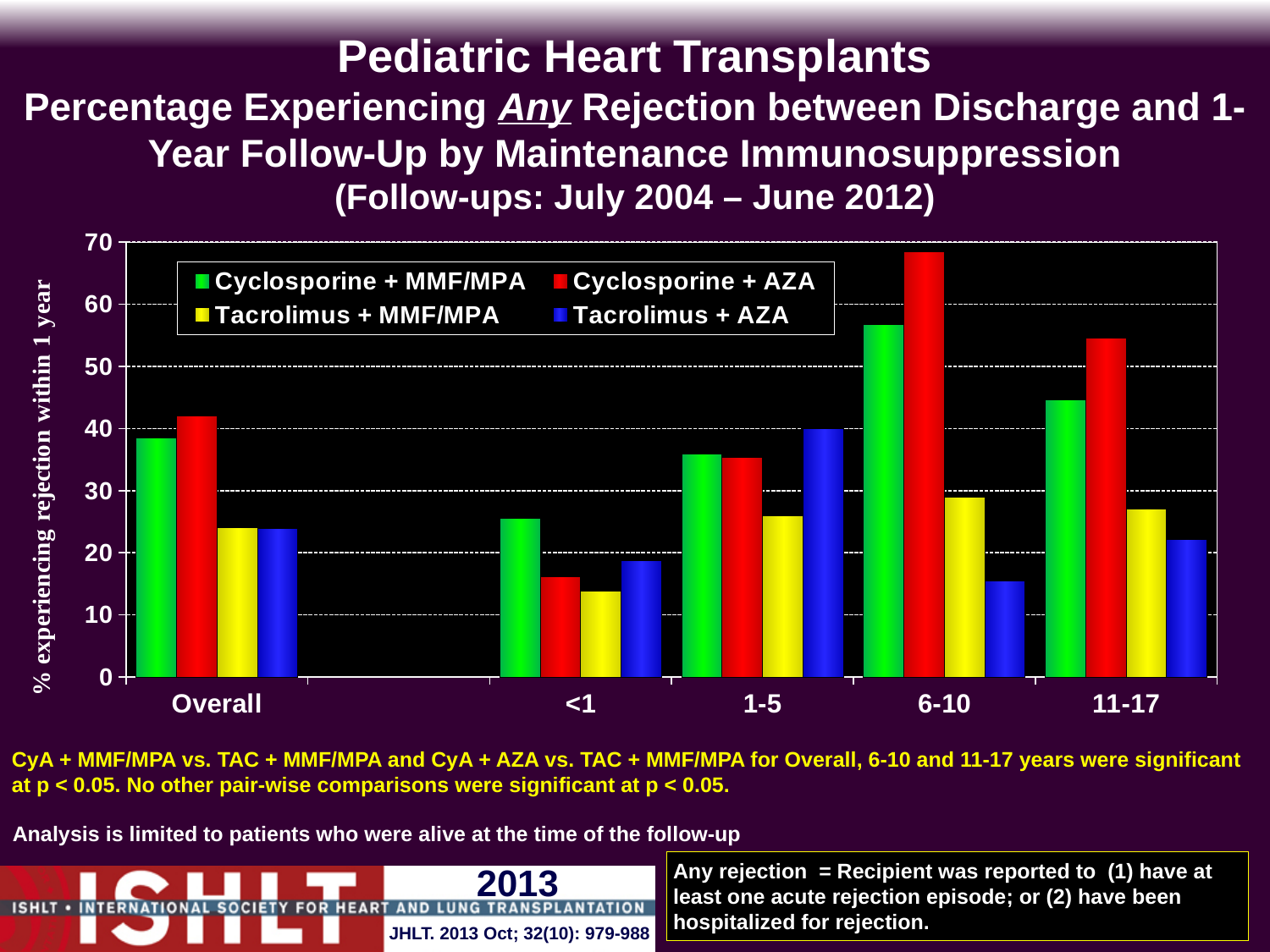
How many series does the legend list? 4 Which category has the lowest value for Tacrolimus + MMF/MPA? <1 What colour represents Tacrolimus + AZA in the chart? blue In the 6-10 group, which is larger: Cyclosporine + AZA or Cyclosporine + MMF/MPA? Cyclosporine + AZA In the <1 group, which series has the highest value? Cyclosporine + MMF/MPA Is the value for Cyclosporine + AZA in the 6-10 group greater or less than 60? greater In the Overall group, which is larger: Cyclosporine + AZA or Tacrolimus + MMF/MPA? Cyclosporine + AZA Is the value for Tacrolimus + AZA in the 6-10 group greater or less than 20? less What kind of chart is shown on the slide? bar chart Is the value for Cyclosporine + MMF/MPA in the Overall group greater or less than 30? greater Which category has the highest value for Cyclosporine + AZA? 6-10 How many age-group categories are shown on the x axis? 4